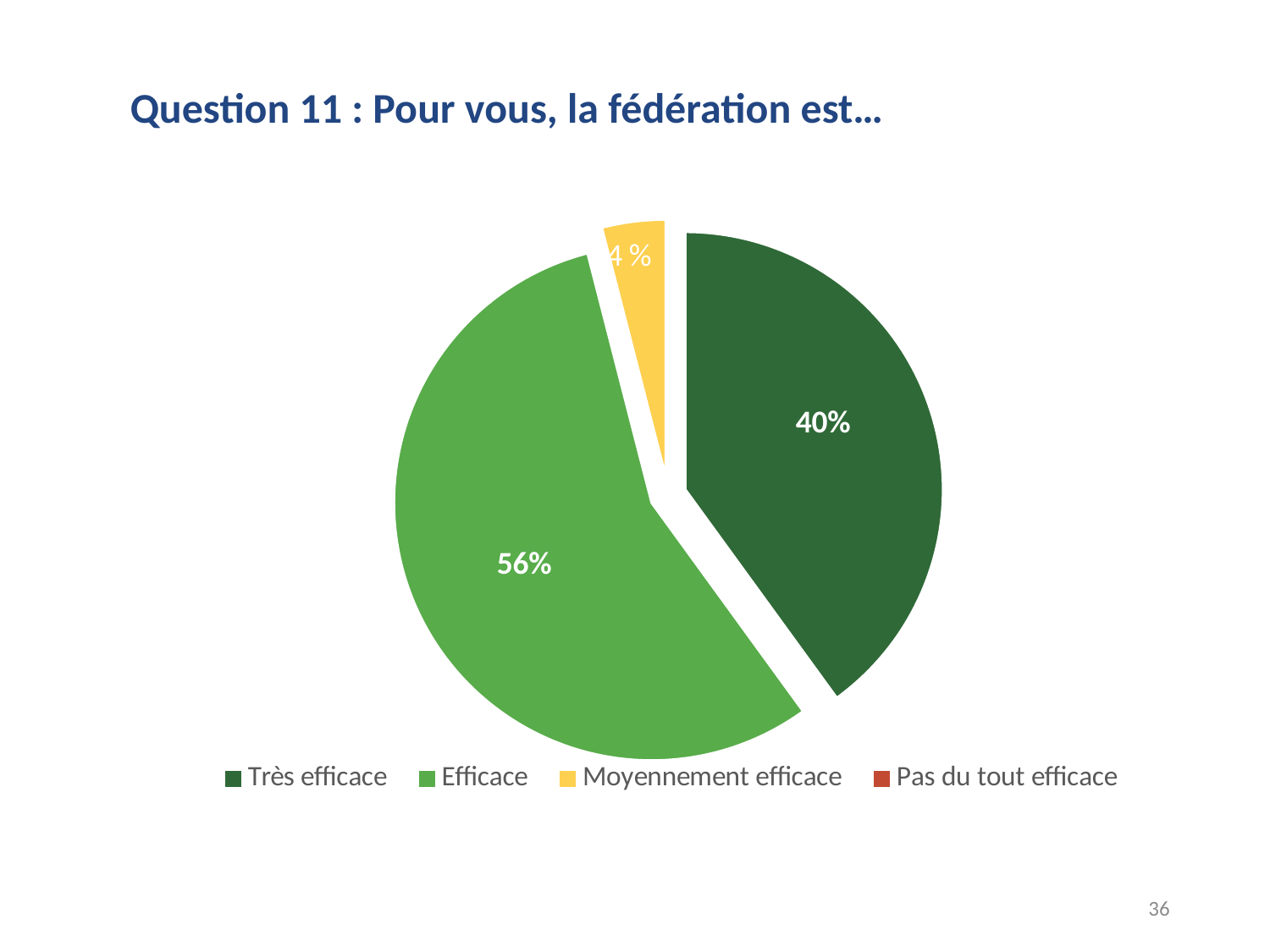
Which category with a visible slice has the smallest share of the pie? Moyennement efficace What percentage of respondents answered "Efficace"? 56% How many categories does the legend list? 4 What type of chart is shown on the slide? Pie chart What percentage of respondents answered "Très efficace"? 40% What is the difference in percentage points between "Efficace" and "Très efficace"? 16 What percentage of respondents answered "Moyennement efficace"? 4 % What is the combined share of "Très efficace" and "Efficace"? 96% What is the title of the chart? Question 11 : Pour vous, la fédération est… Which category has the largest share of the pie? Efficace What colour is the slice for "Moyennement efficace"? Yellow Which is larger: the share for "Très efficace" or the share for "Efficace"? Efficace